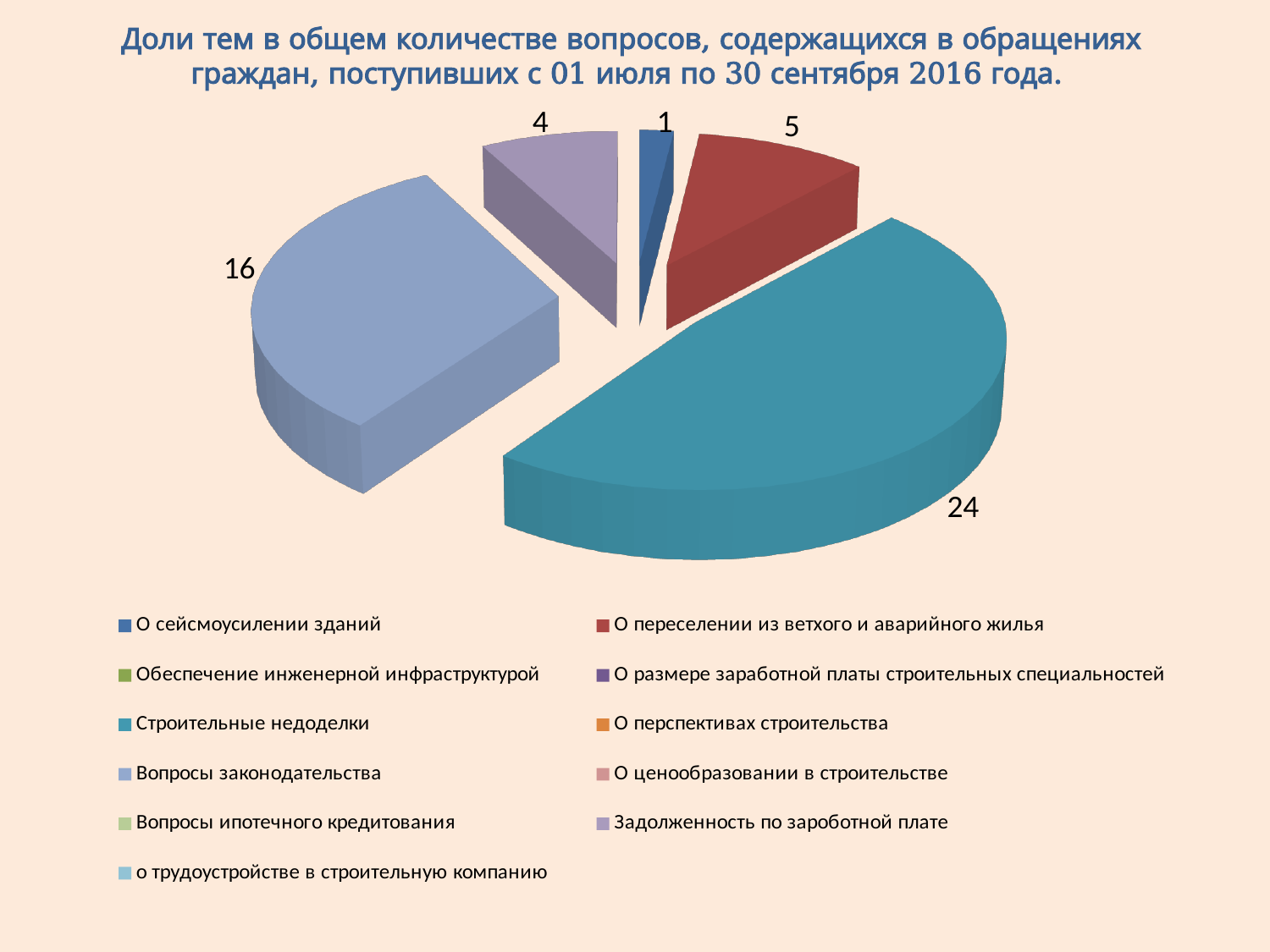
What is the value for Задолженность по заработной плате? 4 Which is larger: the value for О переселении из ветхого и аварийного жилья or the value for Задолженность по заработной плате? О переселении из ветхого и аварийного жилья How many entries does the legend list? 11 What is the value for Строительные недоделки? 24 What is the value for О сейсмоусилении зданий? 1 Which category has the largest slice of the pie? Строительные недоделки What is the difference between the values for Строительные недоделки and Вопросы законодательства? 8 What is the value for Вопросы законодательства? 16 What is the value for О переселении из ветхого и аварийного жилья? 5 How many slices with data labels are shown in the pie? 5 What kind of chart is shown on the slide? pie chart Which of the labelled slices has the smallest value? О сейсмоусилении зданий